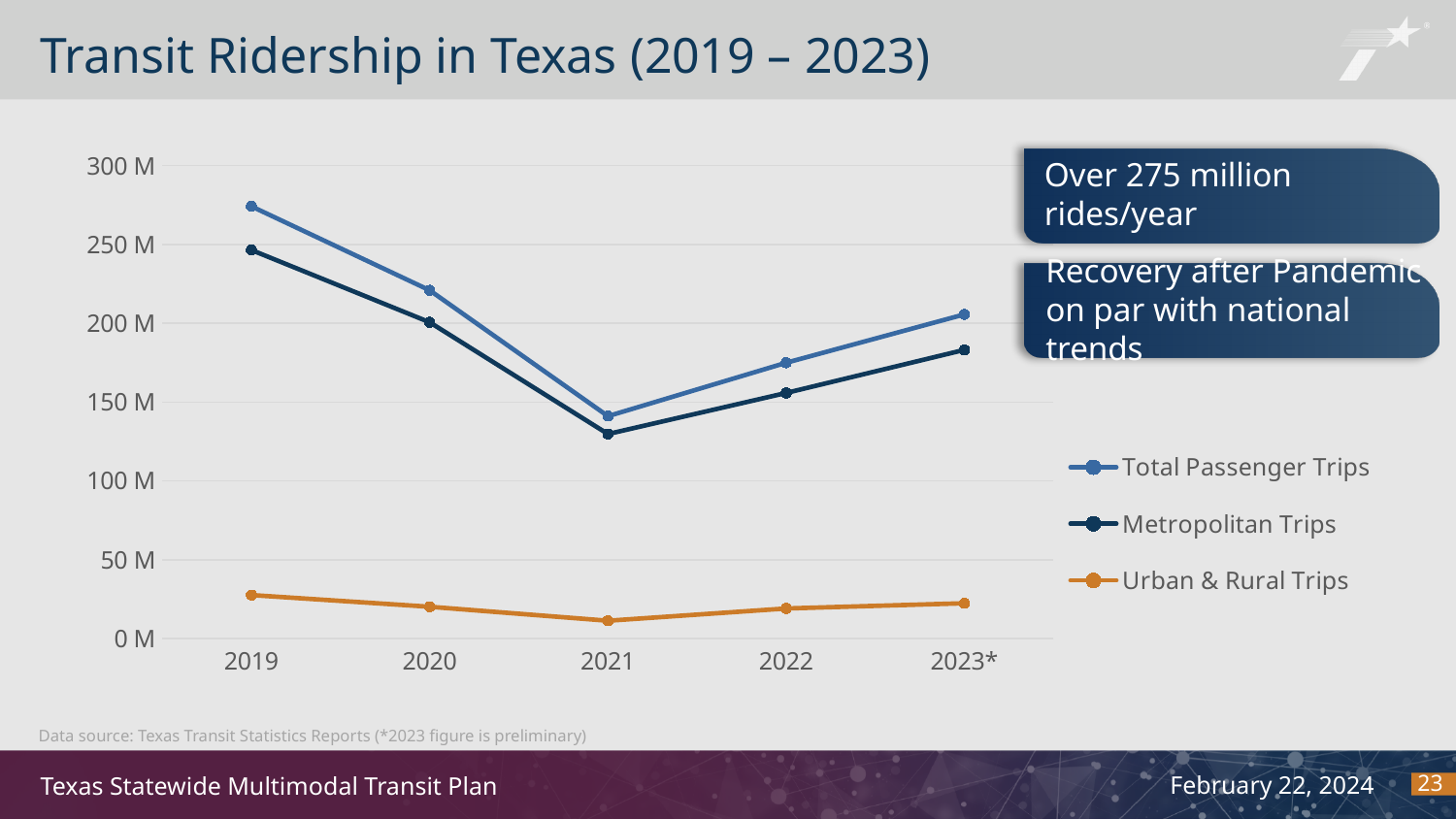
Is the value for Urban & Rural Trips in 2019 greater or less than 50 M? less Which is larger in 2019: Metropolitan Trips or Urban & Rural Trips? Metropolitan Trips In which year is the Total Passenger Trips value highest? 2019 What is the title of the chart slide? Transit Ridership in Texas (2019 – 2023) What kind of chart is shown on the slide? Line chart Do the Total Passenger Trips values rise or fall from 2021 to 2023*? Rise Is the value for Metropolitan Trips in 2023* greater or less than 200 M? less Is the value for Metropolitan Trips in 2021 greater or less than 150 M? less How many years are plotted along the x axis of the chart? 5 How many series does the chart legend list? 3 In which year is the Total Passenger Trips value lowest? 2021